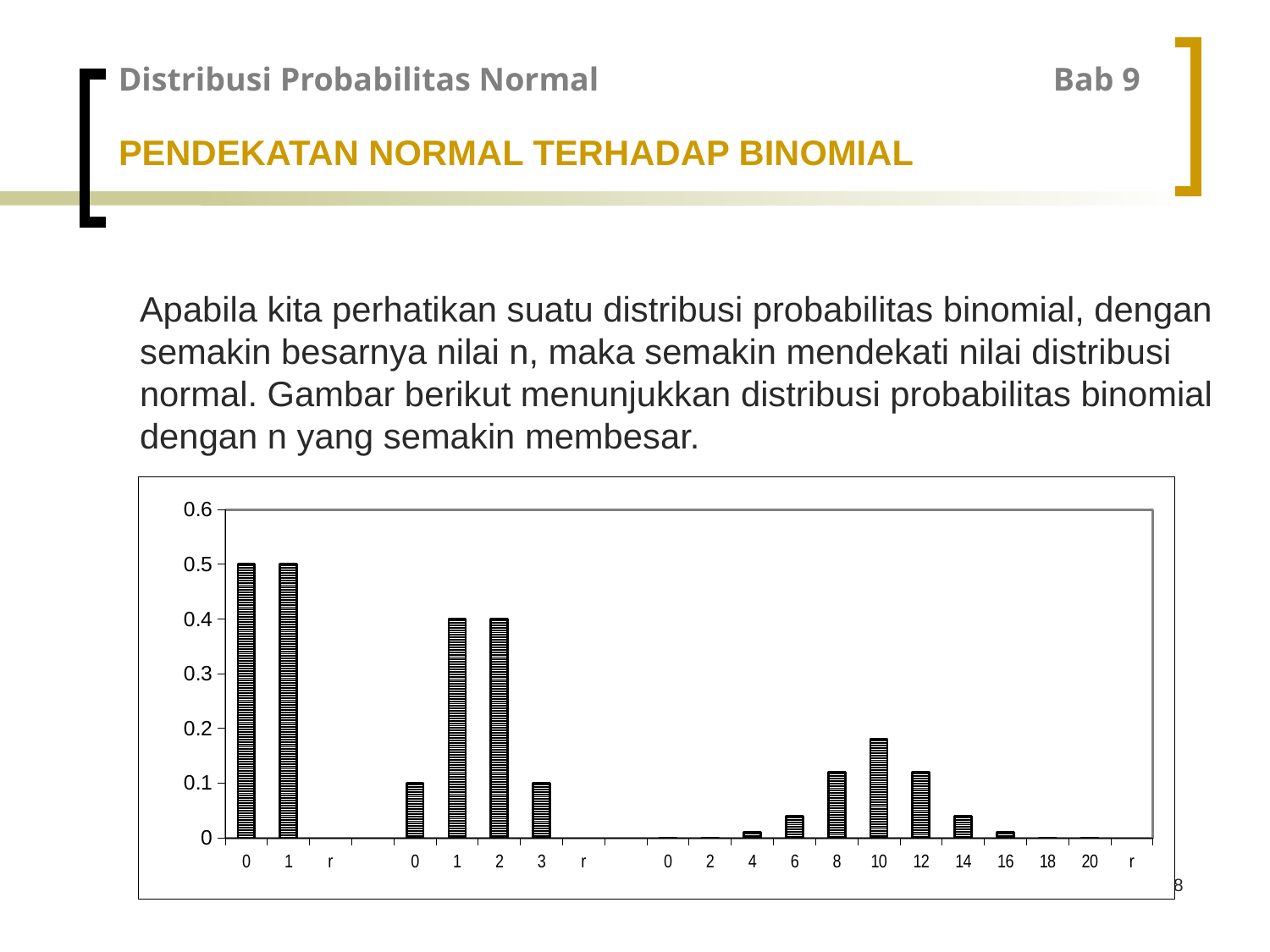
In the middle group of bars (r = 0 to 3), what is the value for r = 1? 0.4 In the middle group of bars (r = 0 to 3), what is the value for r = 3? 0.1 In the rightmost group of bars, is the value for r = 6 greater or less than 0.1? less In the leftmost group of bars, what is the value for r = 0? 0.5 What is the highest value shown on the vertical axis of the chart? 0.6 In the rightmost group of bars, is the value for r = 10 greater or less than 0.1? greater What kind of chart is shown on the slide? bar chart In the rightmost group of bars, is the value for r = 10 greater or less than 0.2? less In the rightmost group of bars, which is larger, the value for r = 10 or the value for r = 14? r = 10 In the rightmost group of bars, do the values rise or fall as r goes from 4 to 10? rise In the middle group of bars (r = 0 to 3), which is larger, the value for r = 2 or the value for r = 3? r = 2 In the rightmost group of bars (r = 0 to 20), which r value has the highest bar? 10